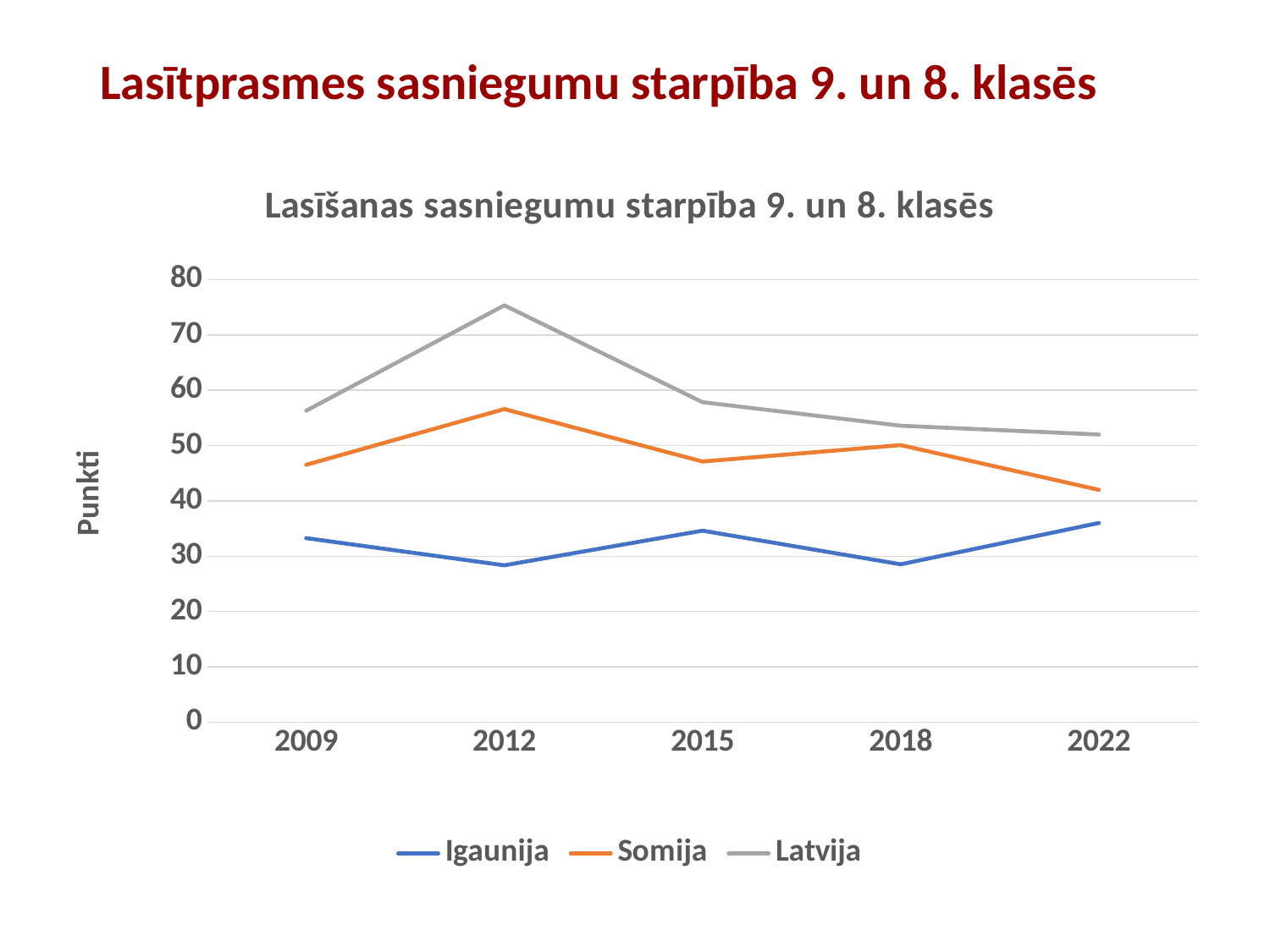
In which year does the Latvija line reach its highest value? 2012 In which year does the Somija line reach its lowest value? 2022 Is the value for Somija in 2022 greater or less than 40? greater Which series has the larger value in 2018, Somija or Igaunija? Somija Does the Latvija line rise or fall from 2012 to 2022? fall How many years are shown on the x axis? 5 Is the value for Igaunija in 2012 greater or less than 30? less How many series does the legend list? 3 What is the label of the vertical axis? Punkti Is the value for Latvija in 2012 greater or less than 70? greater What kind of chart is shown on the slide? line chart What is the title of the chart? Lasīšanas sasniegumu starpība 9. un 8. klasēs